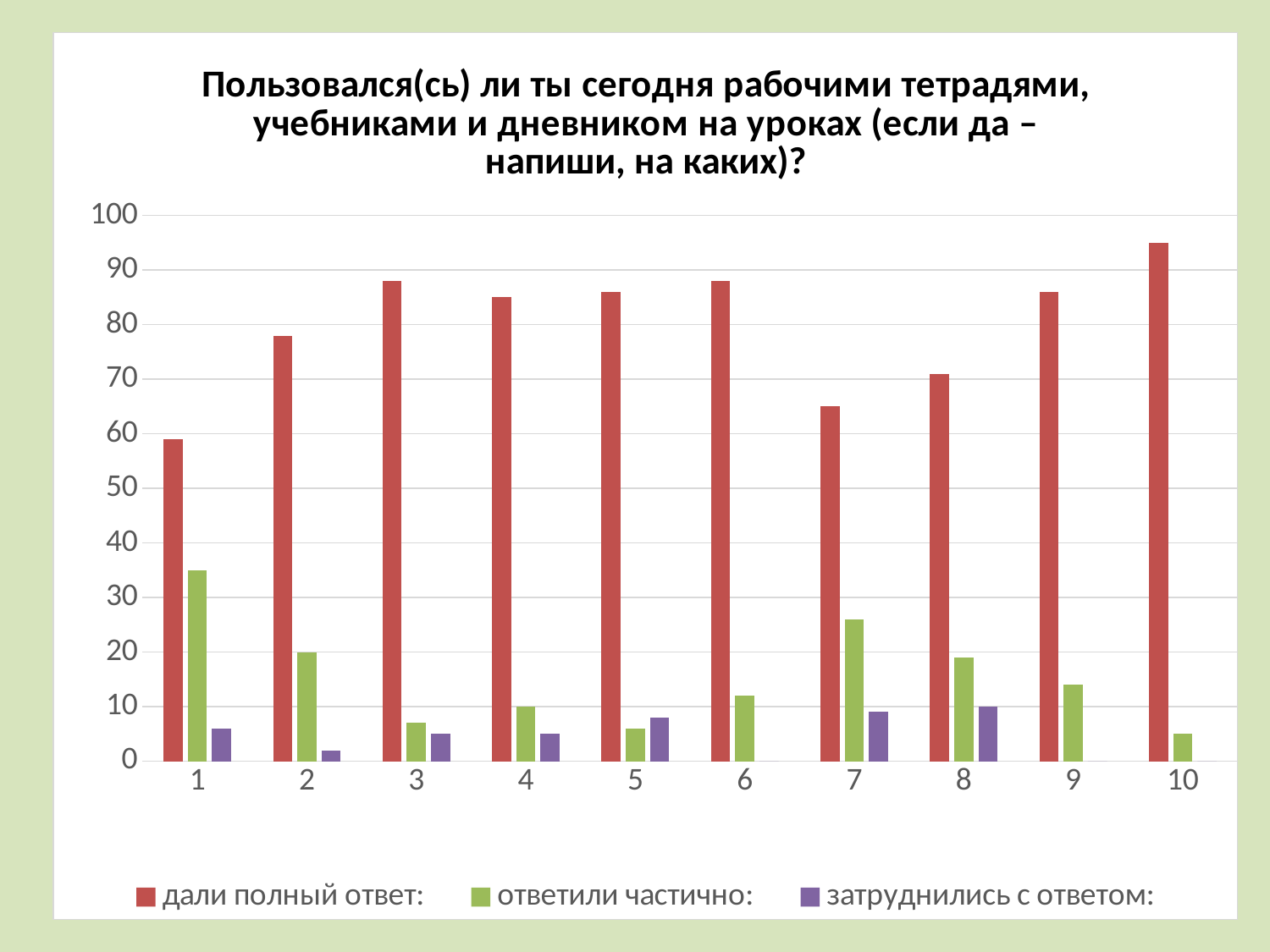
For the series "дали полный ответ:", which is larger: category 2 or category 7? category 2 Is the value for "ответили частично:" in category 1 greater or less than 30? greater Is the value for "дали полный ответ:" in category 7 greater or less than 70? less How many series does the legend list? 3 What kind of chart is shown on the slide? bar chart Is the value for "дали полный ответ:" in category 1 greater or less than 50? greater Which category has the highest value for the series "ответили частично:"? 1 Which category has the lowest value for the series "дали полный ответ:"? 1 How many categories are shown along the x axis? 10 Which category has the highest value for the series "дали полный ответ:"? 10 Which colour represents the series "затруднились с ответом:" in the legend? purple